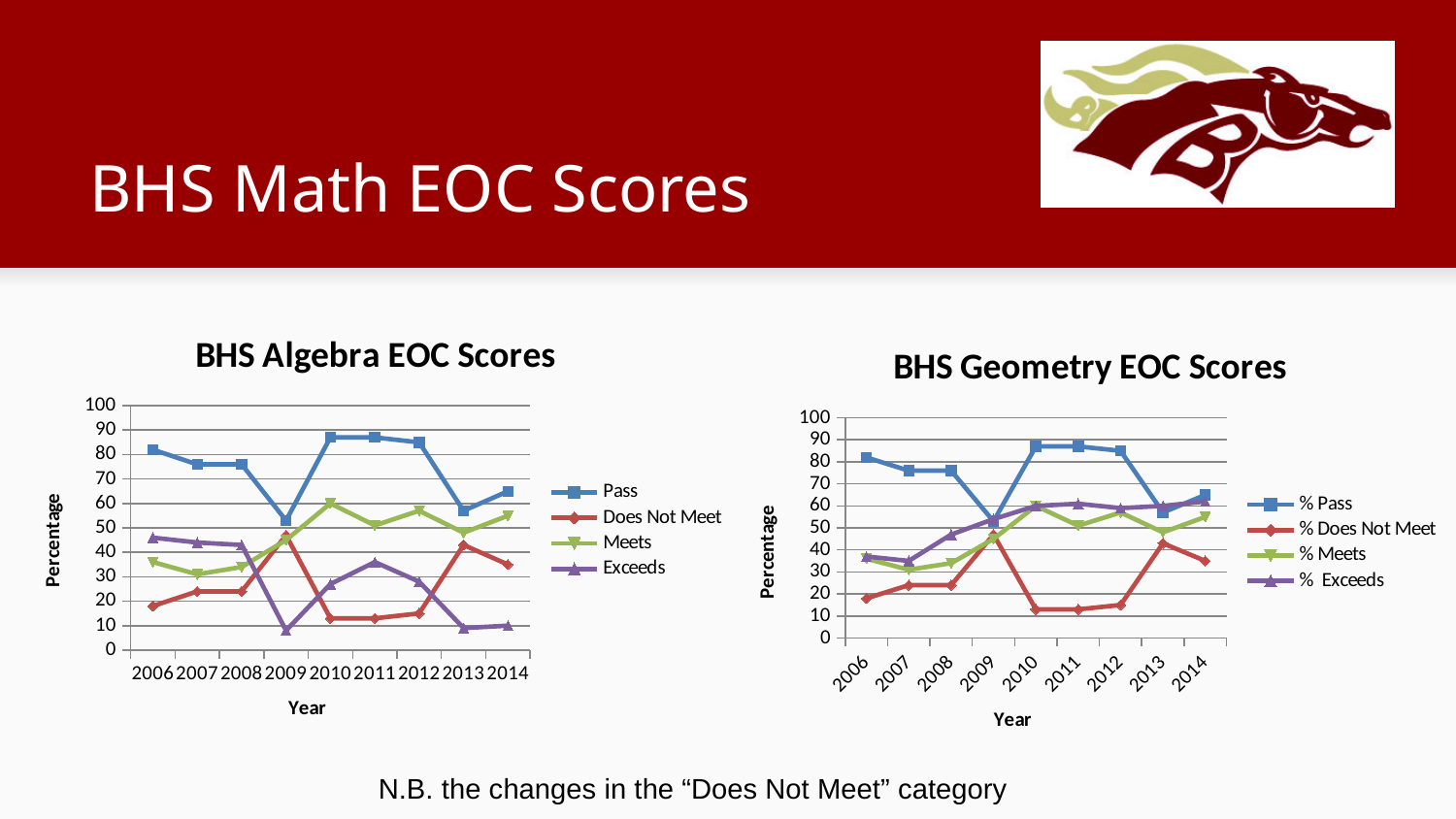
In the BHS Algebra EOC Scores chart, which year has the highest Does Not Meet value? 2009 In the BHS Algebra EOC Scores chart, is the Pass value for 2010 greater or less than 80? greater What kind of chart is the BHS Algebra EOC Scores chart? line chart In the BHS Geometry EOC Scores chart, does the % Exceeds series rise or fall from 2006 to 2010? rise In the BHS Geometry EOC Scores chart, which is larger in 2014: % Exceeds or % Does Not Meet? % Exceeds How many series does the legend of the BHS Algebra EOC Scores chart list? 4 In the BHS Algebra EOC Scores chart, does the Pass series rise or fall from 2012 to 2013? fall What are the legend entries of the BHS Geometry EOC Scores chart? % Pass, % Does Not Meet, % Meets, % Exceeds In the BHS Algebra EOC Scores chart, is the Exceeds value for 2009 greater or less than 20? less In the BHS Algebra EOC Scores chart, which year has the lowest Pass value? 2009 How many years are plotted on the x axis of the BHS Geometry EOC Scores chart? 9 In the BHS Geometry EOC Scores chart, is the % Does Not Meet value for 2010 greater or less than 20? less